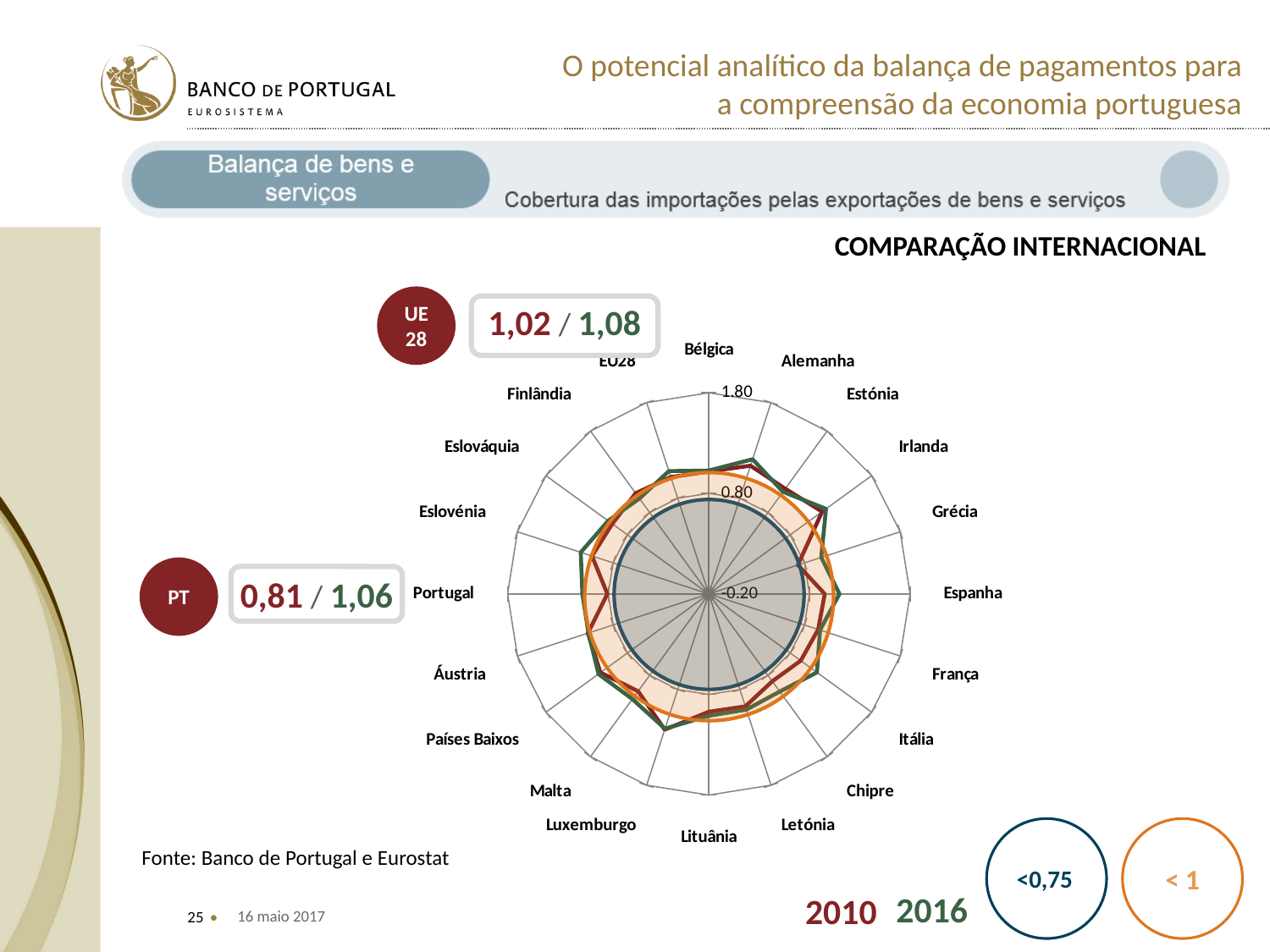
By how much did the value for Portugal increase from 2010 to 2016? 0,25 How many categories (countries/regions) are plotted around the radar chart? 20 What kind of chart is shown on the slide? radar chart What is the value for Portugal in 2016? 1,06 Which had the larger value in 2010, UE 28 or Portugal? UE 28 Which is larger for Portugal, the 2010 value or the 2016 value? 2016 How many series does the chart show (years)? 2 Is the 2016 value for Irlanda greater or less than 0.80? greater What is the value for Portugal in 2010? 0,81 What colour is used for the 2016 series? green What is the value for UE 28 in 2016? 1,08 What is the value for UE 28 in 2010? 1,02